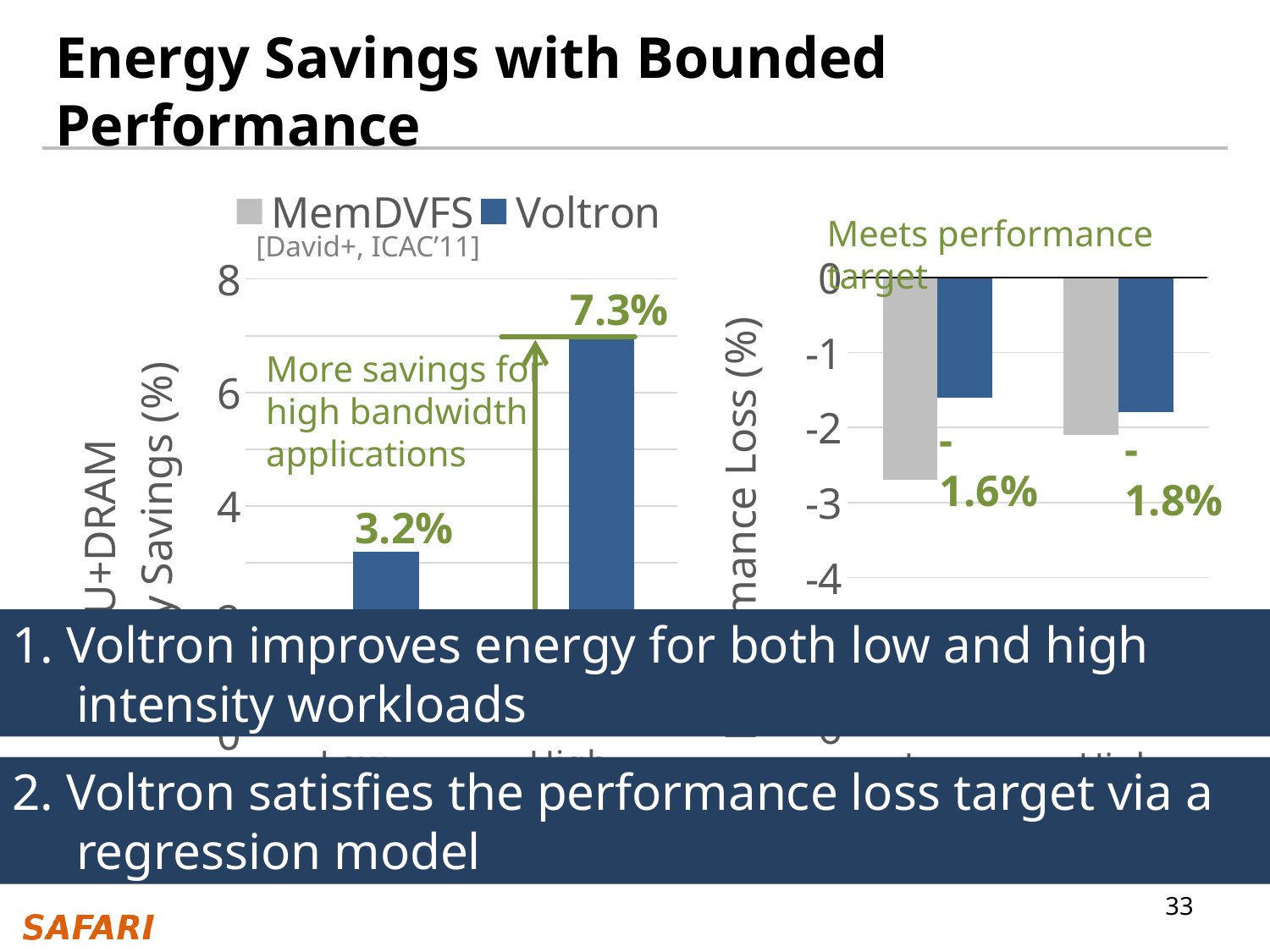
In the left chart (energy savings), what value is printed on the shorter Voltron bar? 3.2% In the left chart (energy savings), what value is printed on the taller Voltron bar? 7.3% How many series does the legend list? 2 In the left chart (energy savings), which Voltron bar is higher, the left-hand one or the right-hand one? the right-hand one What is the highest tick value shown on the y axis of the left chart (energy savings)? 8 In the right chart (performance loss), is the MemDVFS value in the left group greater or less than -2? less In the right chart (performance loss), what value is printed on the Voltron bar in the left group? -1.6% How many bars are plotted in the right chart (performance loss)? 4 In the right chart (performance loss), what value is printed on the Voltron bar in the right group? -1.8% What kind of chart is the left chart (energy savings)? bar chart In the left chart (energy savings), what is the difference between the two labelled Voltron values, 7.3% and 3.2%? 4.1% In the right chart (performance loss), in the left group, which series' bar extends further below zero, MemDVFS or Voltron? MemDVFS